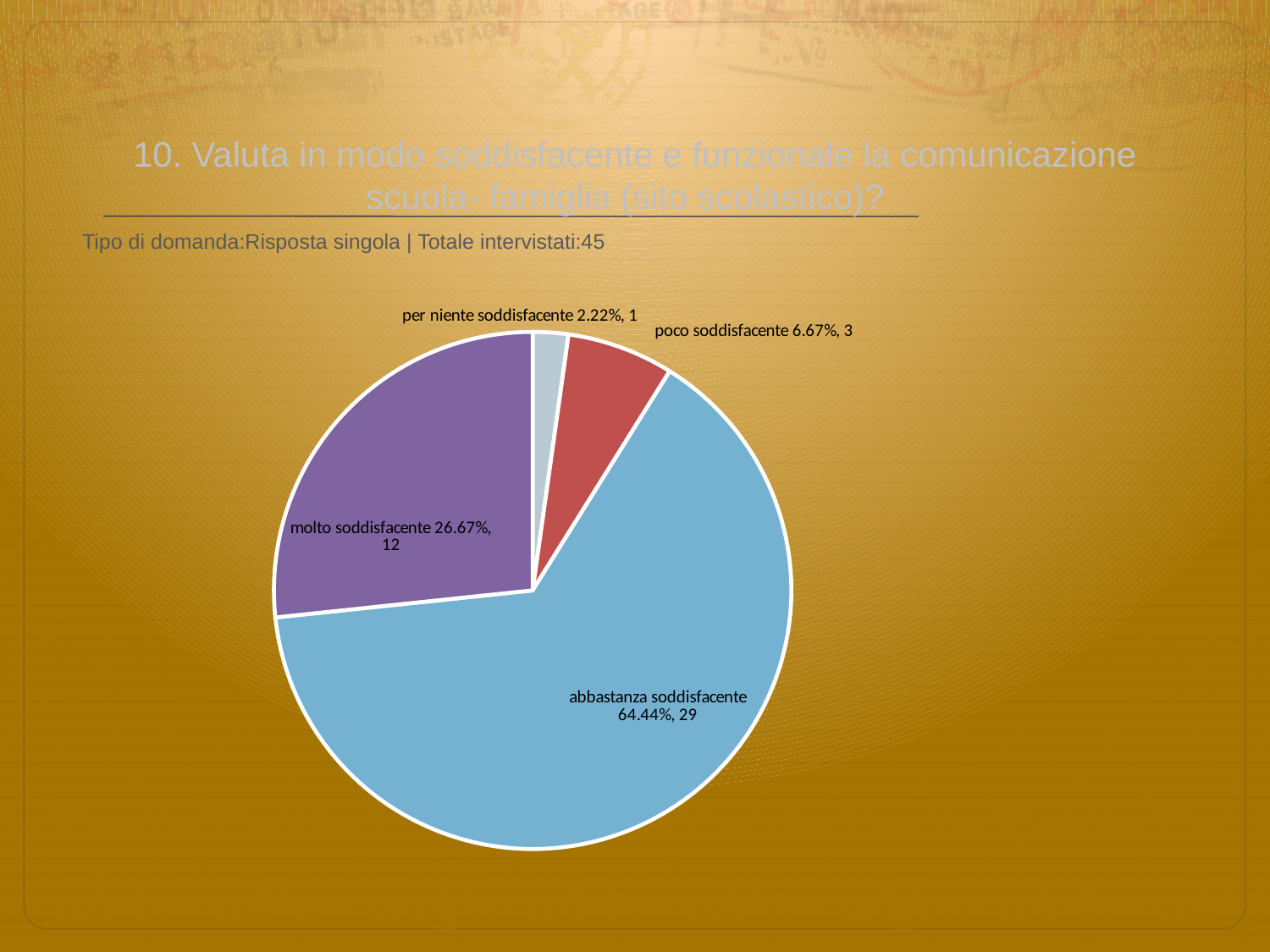
How many respondents answered 'poco soddisfacente'? 3 What percentage share does the 'per niente soddisfacente' slice have? 2.22% What is the difference in respondent count between 'abbastanza soddisfacente' and 'molto soddisfacente'? 17 What is the total number of respondents across all slices? 45 Which category has the largest slice of the pie? abbastanza soddisfacente How many slices does the pie chart have? 4 How many respondents answered 'molto soddisfacente'? 12 Which category has the smallest slice of the pie? per niente soddisfacente What percentage share does the 'abbastanza soddisfacente' slice have? 64.44% What kind of chart is shown on the slide? pie chart What colour is the 'molto soddisfacente' slice? purple Which has more respondents, 'poco soddisfacente' or 'molto soddisfacente'? molto soddisfacente